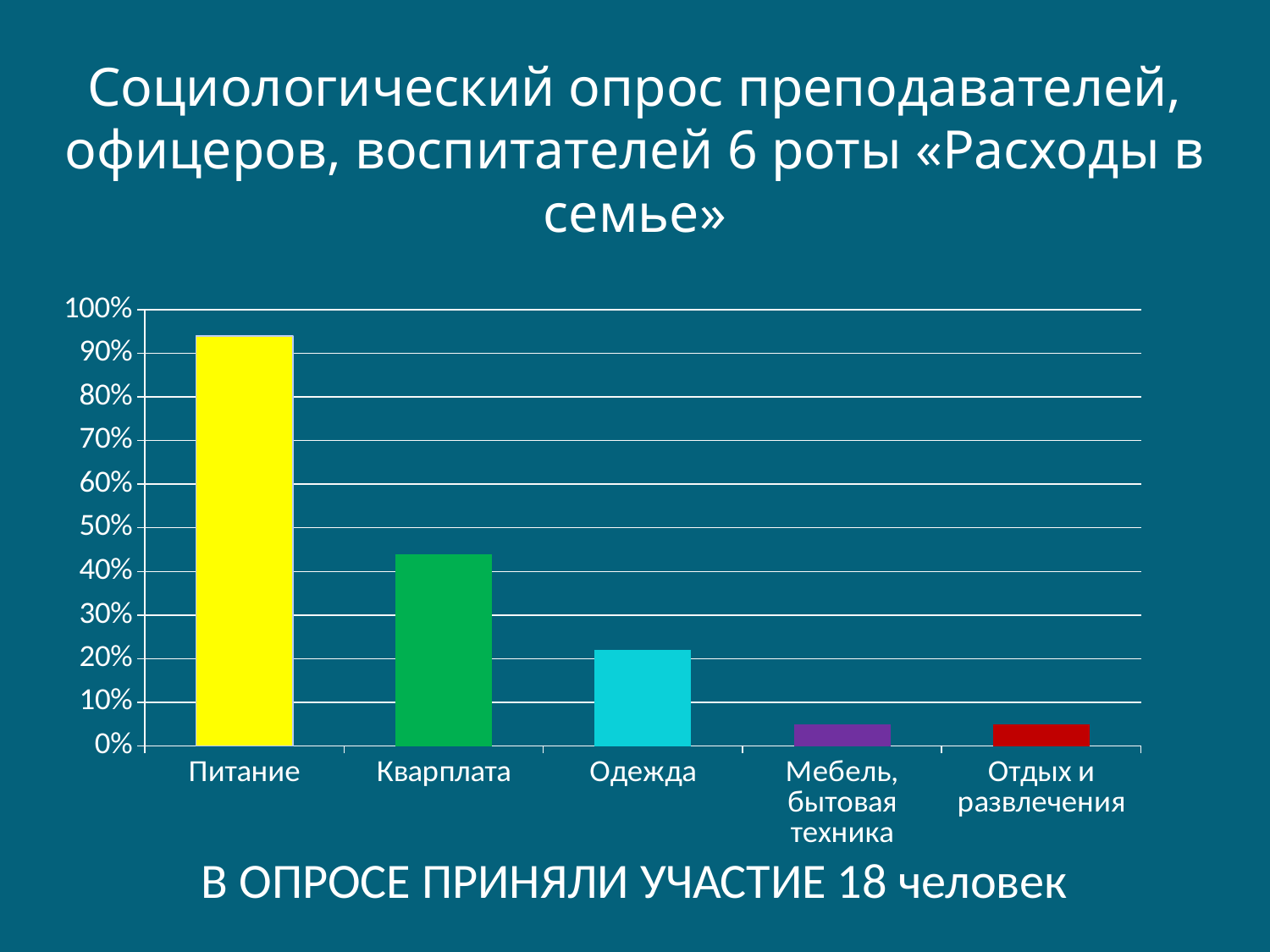
How many categories are shown on the x axis of the chart? 5 Is the value for Кварплата greater or less than 50%? less Which category has the highest value in the chart? Питание Do the values rise or fall from Питание to Одежда along the x axis? fall Is the value for Кварплата greater or less than 40%? greater Is the value for Мебель, бытовая техника greater or less than 10%? less What kind of chart is shown on the slide? bar chart What colour is the bar for Питание? yellow Which is larger, the value for Кварплата or the value for Одежда? Кварплата